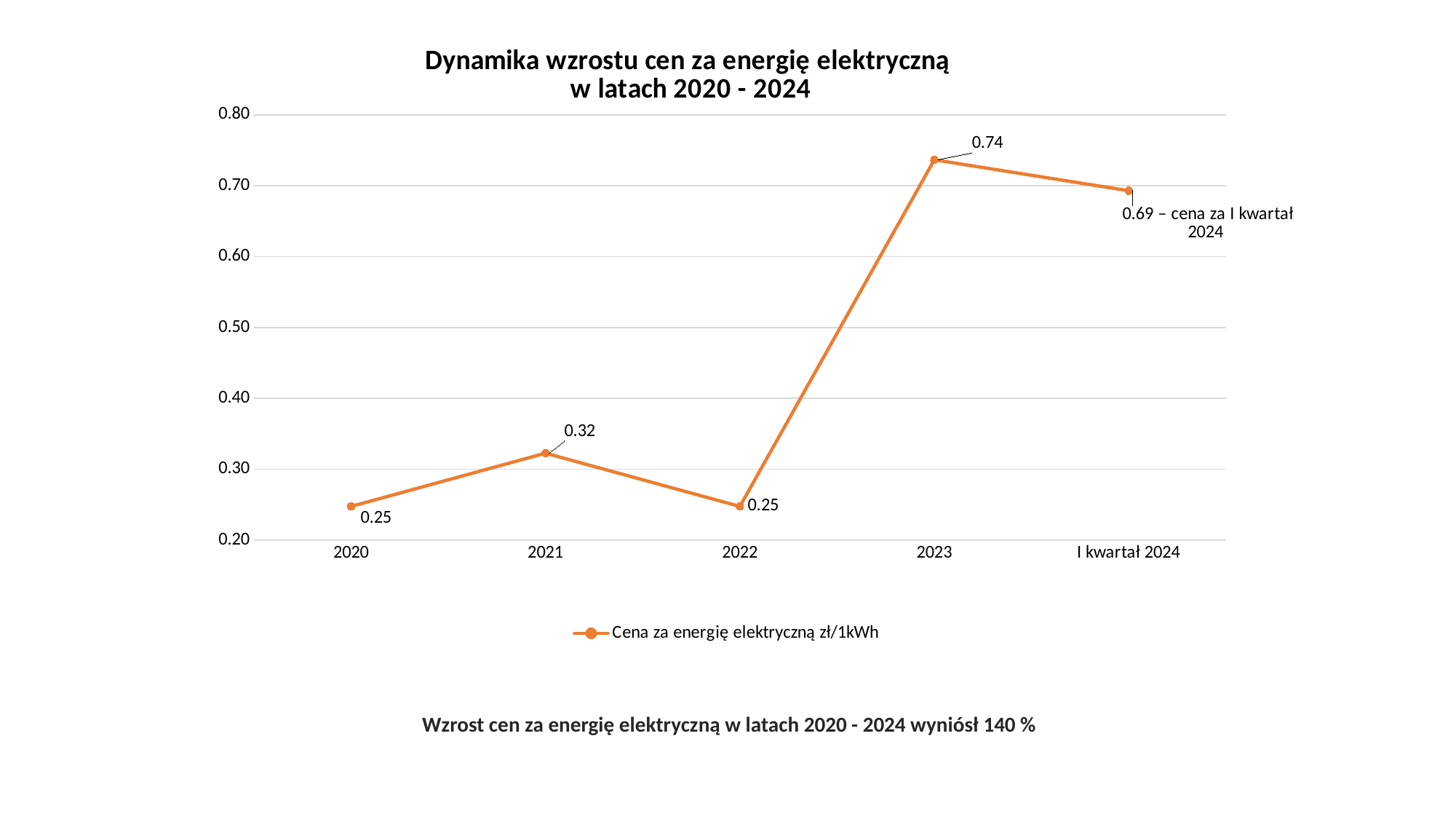
Does the value rise or fall from 2022 to 2023? rise What is the difference between the values for 2023 and 2020? 0.49 What is the value for I kwartał 2024? 0.69 How many series does the legend list? 1 How many data points are plotted on the chart? 5 What is the value for 2021? 0.32 Which category has the highest value? 2023 What kind of chart is shown on the slide? line chart What is the value for 2023? 0.74 Which is larger, the value for 2021 or the value for 2022? 2021 Is the value for 2023 greater or less than 0.70? greater What is the legend entry for the plotted series? Cena za energię elektryczną zł/1kWh